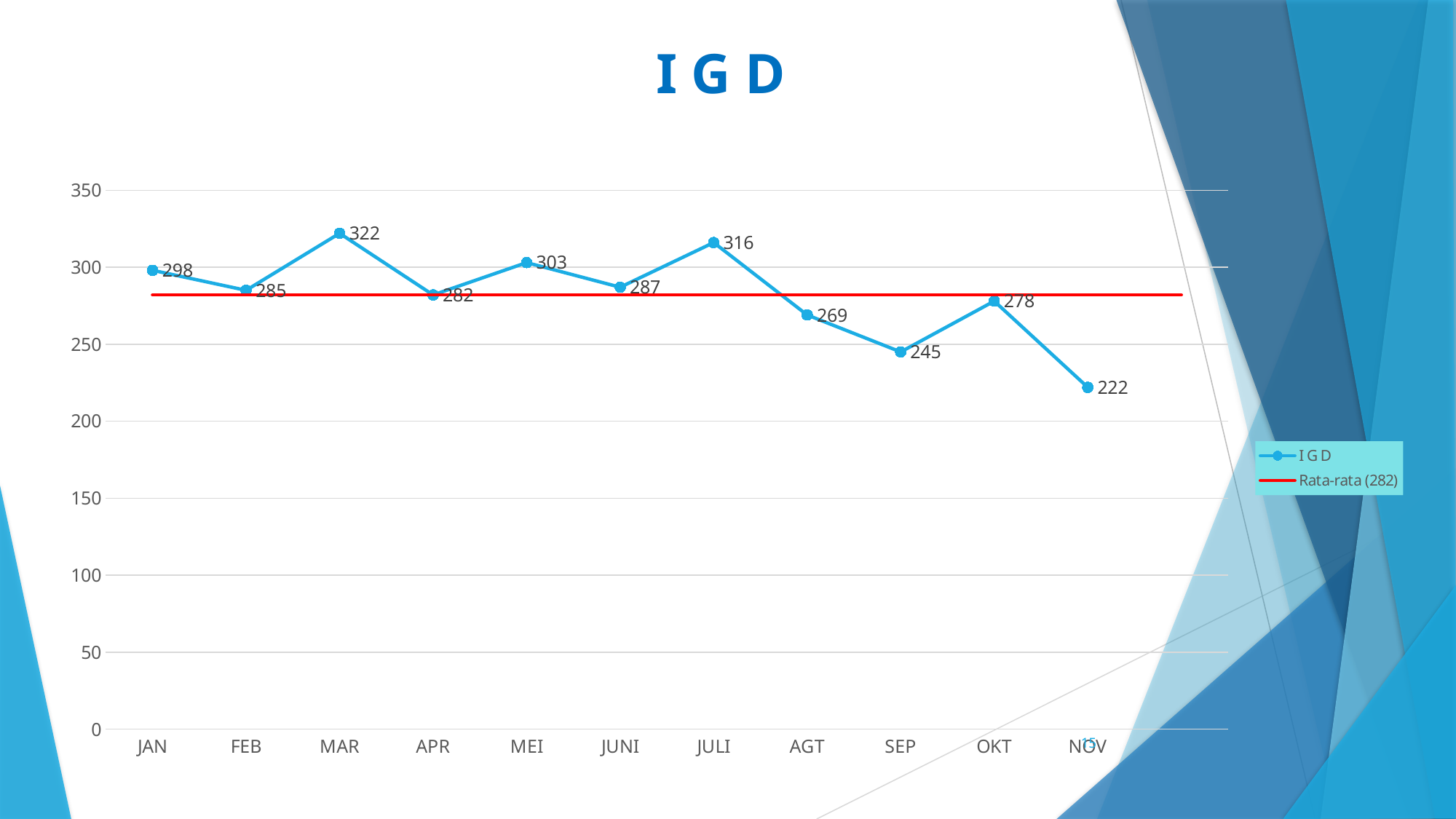
What is the I G D value for JULI? 316 What value does the red Rata-rata line represent according to the legend? 282 Which month has the lowest I G D value? NOV Which month has the highest I G D value? MAR Which month has a higher I G D value, MEI or AGT? MEI What is the I G D value for MAR? 322 How many series does the legend list? 2 What is the difference between the I G D values for MAR and NOV? 100 What is the I G D value for SEP? 245 How many months are plotted on the x axis? 11 Is the I G D value for OKT greater or less than 300? less What kind of chart is shown on the slide? line chart